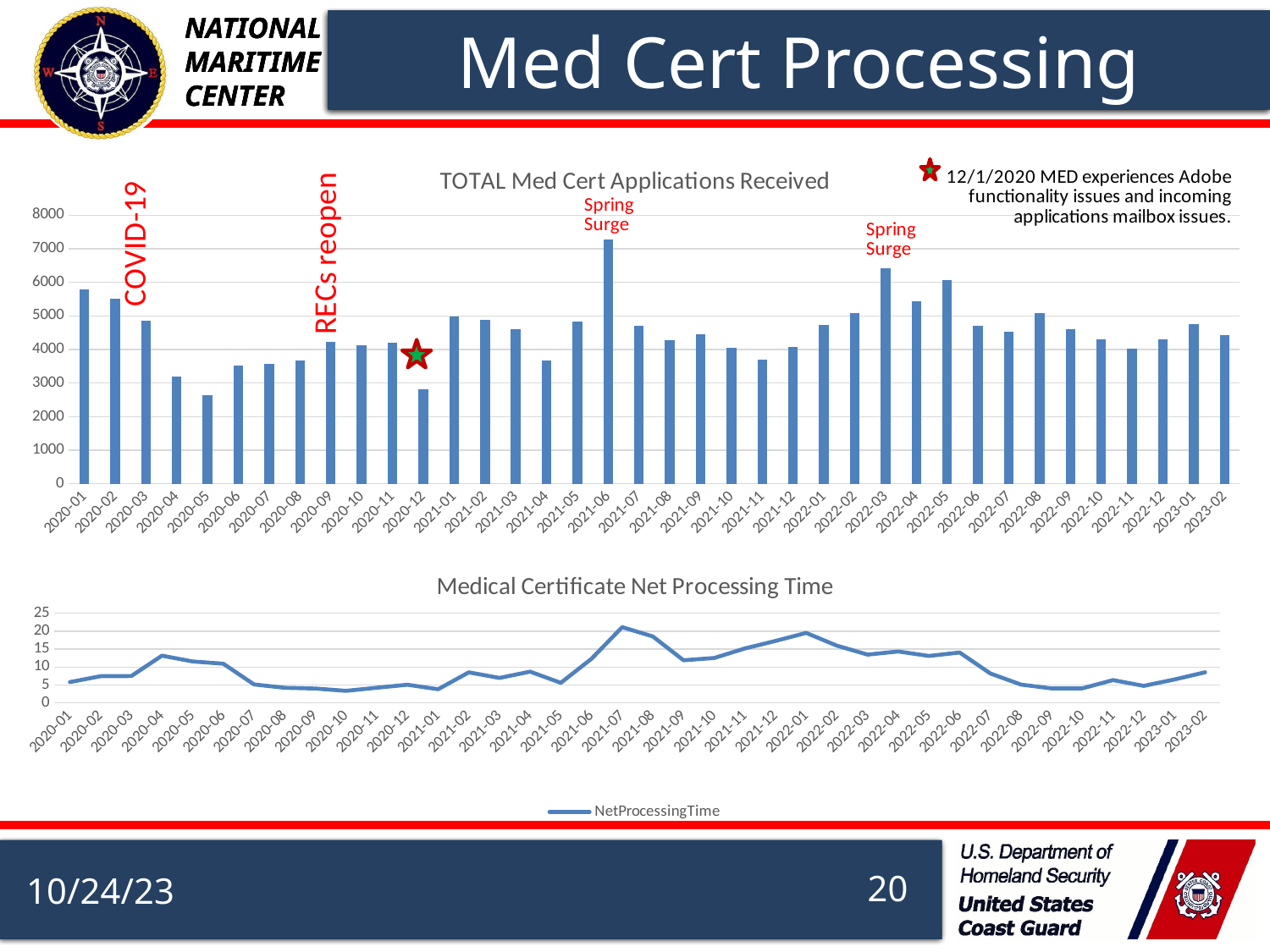
In the 'TOTAL Med Cert Applications Received' chart, is the value for 2022-03 greater or less than 6000? greater In the 'TOTAL Med Cert Applications Received' chart, what red annotation is placed above the 2021-06 bar? Spring Surge In the 'TOTAL Med Cert Applications Received' chart, which is larger, the value for 2020-01 or the value for 2020-04? 2020-01 In the 'TOTAL Med Cert Applications Received' chart, which month has the highest number of applications? 2021-06 In the 'TOTAL Med Cert Applications Received' chart, is the value for 2021-06 greater or less than 7000? greater In the 'Medical Certificate Net Processing Time' chart, which month has the highest net processing time? 2021-07 In the 'Medical Certificate Net Processing Time' chart, is the value for 2021-07 greater or less than 15? greater What type of chart is the 'Medical Certificate Net Processing Time' chart? line chart What type of chart is the 'TOTAL Med Cert Applications Received' chart? bar chart How many series does the legend of the 'Medical Certificate Net Processing Time' chart list? 1 How many months are plotted in the 'TOTAL Med Cert Applications Received' chart? 38